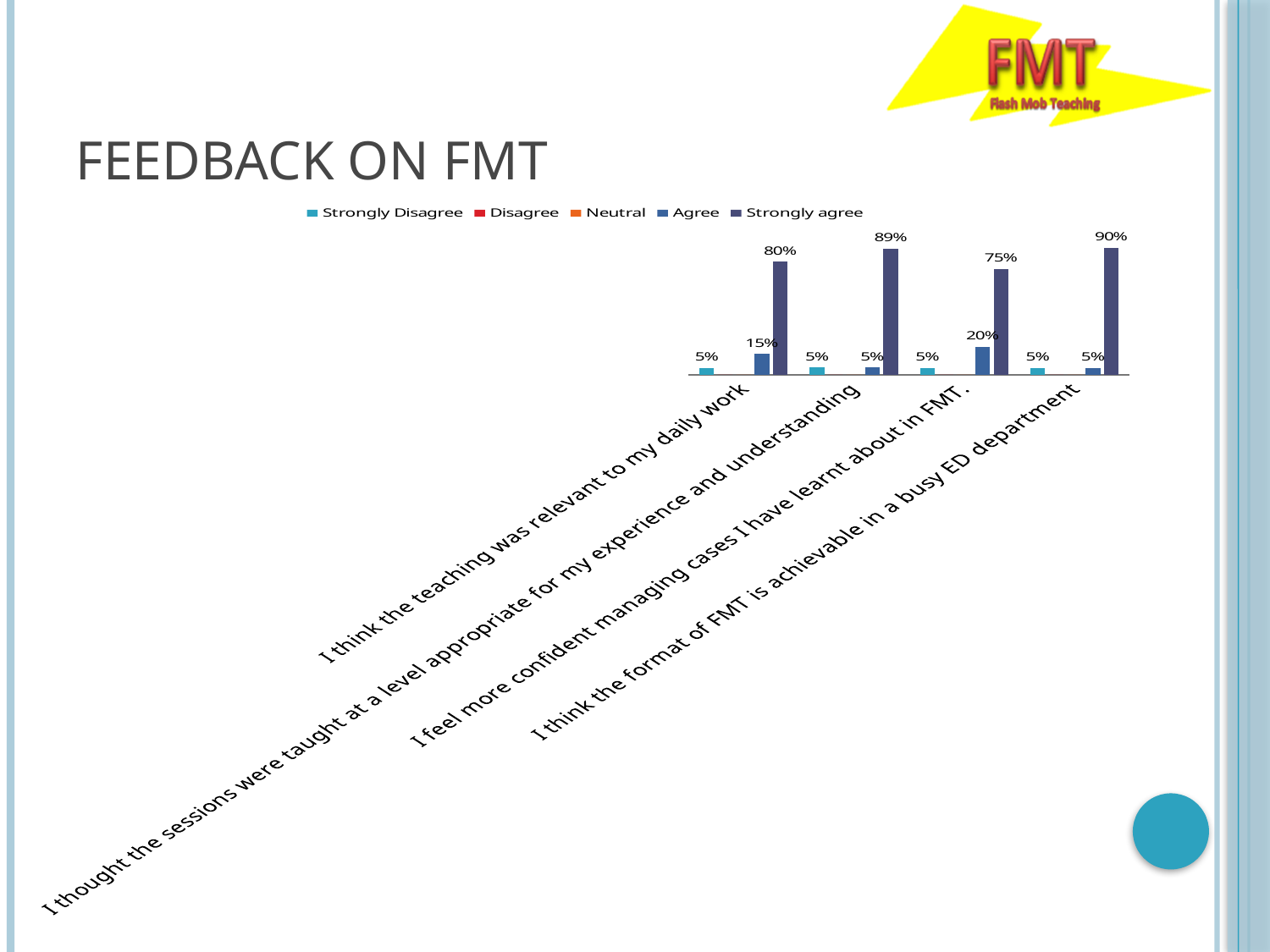
What is the Agree value for "I think the teaching was relevant to my daily work"? 15% Which is larger: the Agree value for "I feel more confident managing cases I have learnt about in FMT." or the Agree value for "I think the teaching was relevant to my daily work"? I feel more confident managing cases I have learnt about in FMT. Which statement has the lowest Strongly agree value? I feel more confident managing cases I have learnt about in FMT. How many series does the legend list? 5 What type of chart is shown on the slide? bar chart What is the Strongly agree value for "I think the teaching was relevant to my daily work"? 80% How many categories (statements) are shown on the x axis? 4 What is the difference between the Strongly agree values for "I think the format of FMT is achievable in a busy ED department" and "I feel more confident managing cases I have learnt about in FMT."? 15% What is the title of the slide containing the chart? FEEDBACK ON FMT What is the Agree value for "I feel more confident managing cases I have learnt about in FMT."? 20% Which statement has the highest Strongly agree value? I think the format of FMT is achievable in a busy ED department What is the Strongly agree value for "I think the format of FMT is achievable in a busy ED department"? 90%